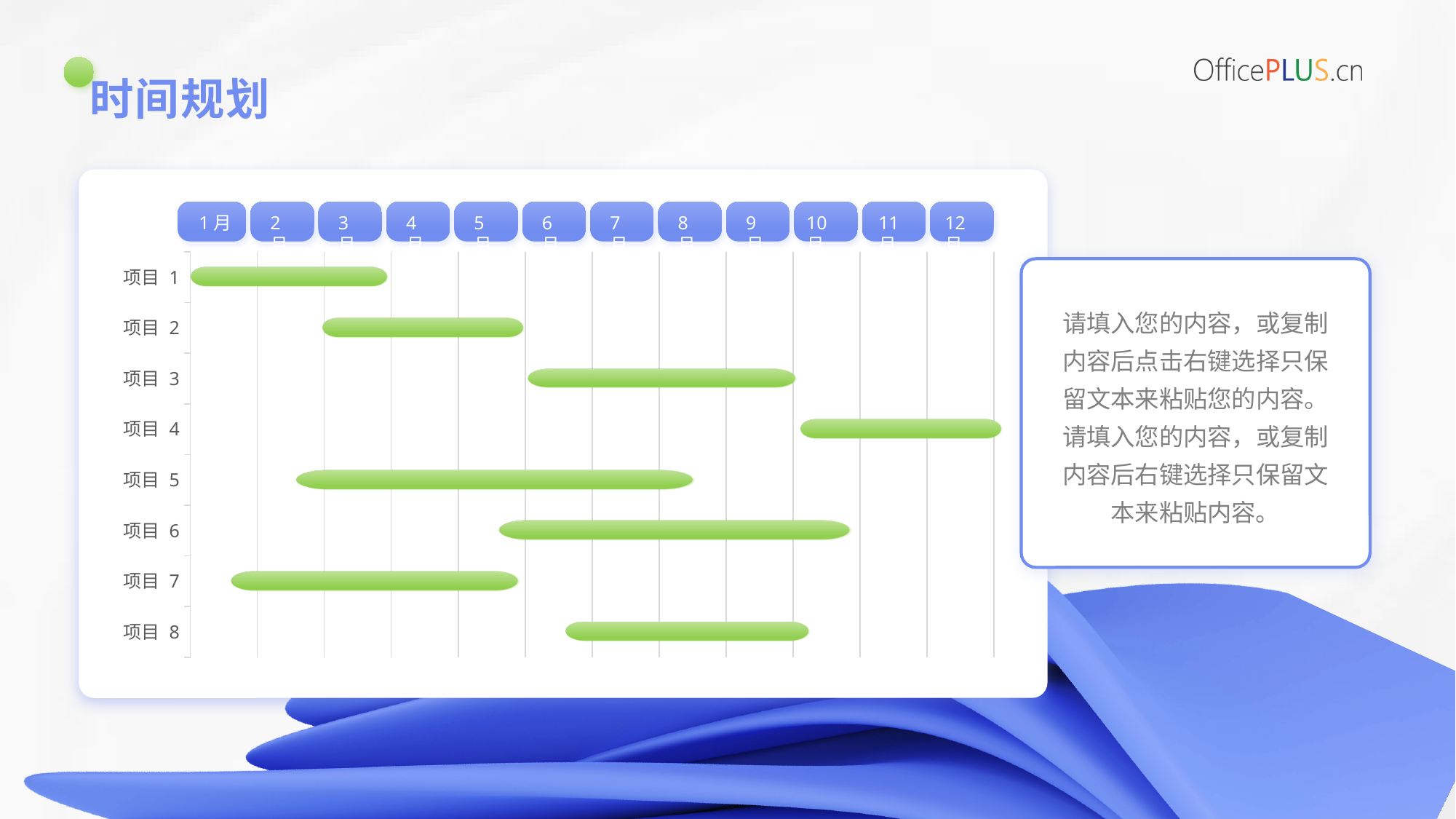
Which bar is longer, 项目 6 or 项目 3? 项目 6 Which bar is longer, 项目 5 or 项目 1? 项目 5 Which project has the longest bar on the chart? 项目 5 Which bar is longer, 项目 7 or 项目 2? 项目 7 What is the title of the slide containing the chart? 时间规划 How many month columns does the chart's time axis show? 12 How many projects (项目) are listed on the chart? 8 What colour are the bars on the chart? Green Which project's bar starts earliest in the year? 项目 1 Which project's bar extends furthest to the right, ending in 12 月? 项目 4 What kind of chart is shown on the slide? Gantt chart (horizontal bar chart)